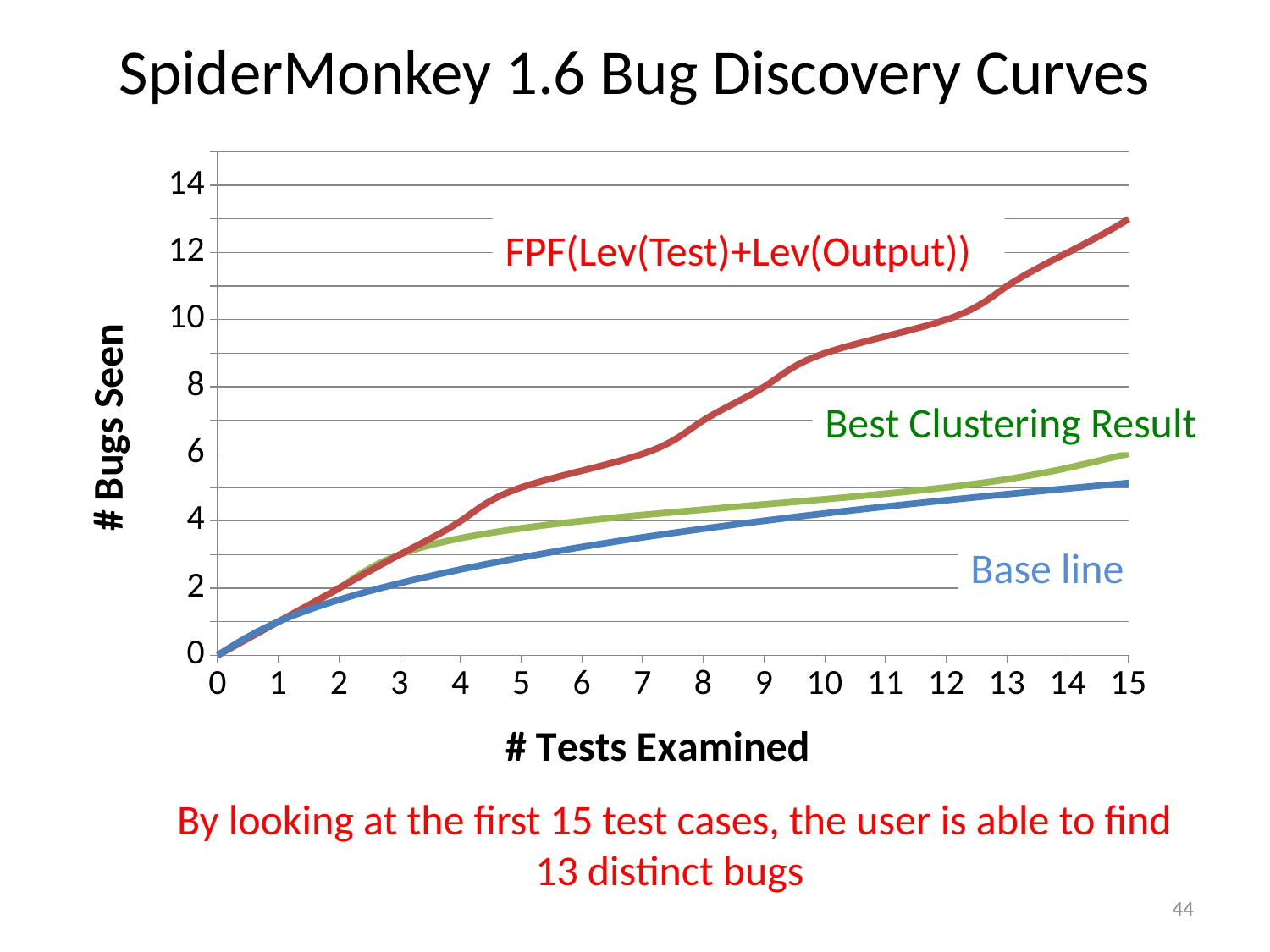
How many series are plotted on the chart? 3 What is the label of the y axis? # Bugs Seen Which series has the highest number of bugs seen at 15 tests examined? FPF(Lev(Test)+Lev(Output)) At 15 tests examined, which is larger: Best Clustering Result or Base line? Best Clustering Result Is the value for FPF(Lev(Test)+Lev(Output)) at 10 tests examined greater or less than 8? greater Is the value for Best Clustering Result at 15 tests examined greater or less than 4? greater What is the title of the chart? SpiderMonkey 1.6 Bug Discovery Curves Which series has the lowest number of bugs seen at 15 tests examined? Base line What type of chart is shown on the slide? Line chart Do the curves rise or fall as the number of tests examined increases? Rise How many bugs has the FPF(Lev(Test)+Lev(Output)) curve found after 15 tests examined? 13 Is the value for Base line at 15 tests examined greater or less than 6? less